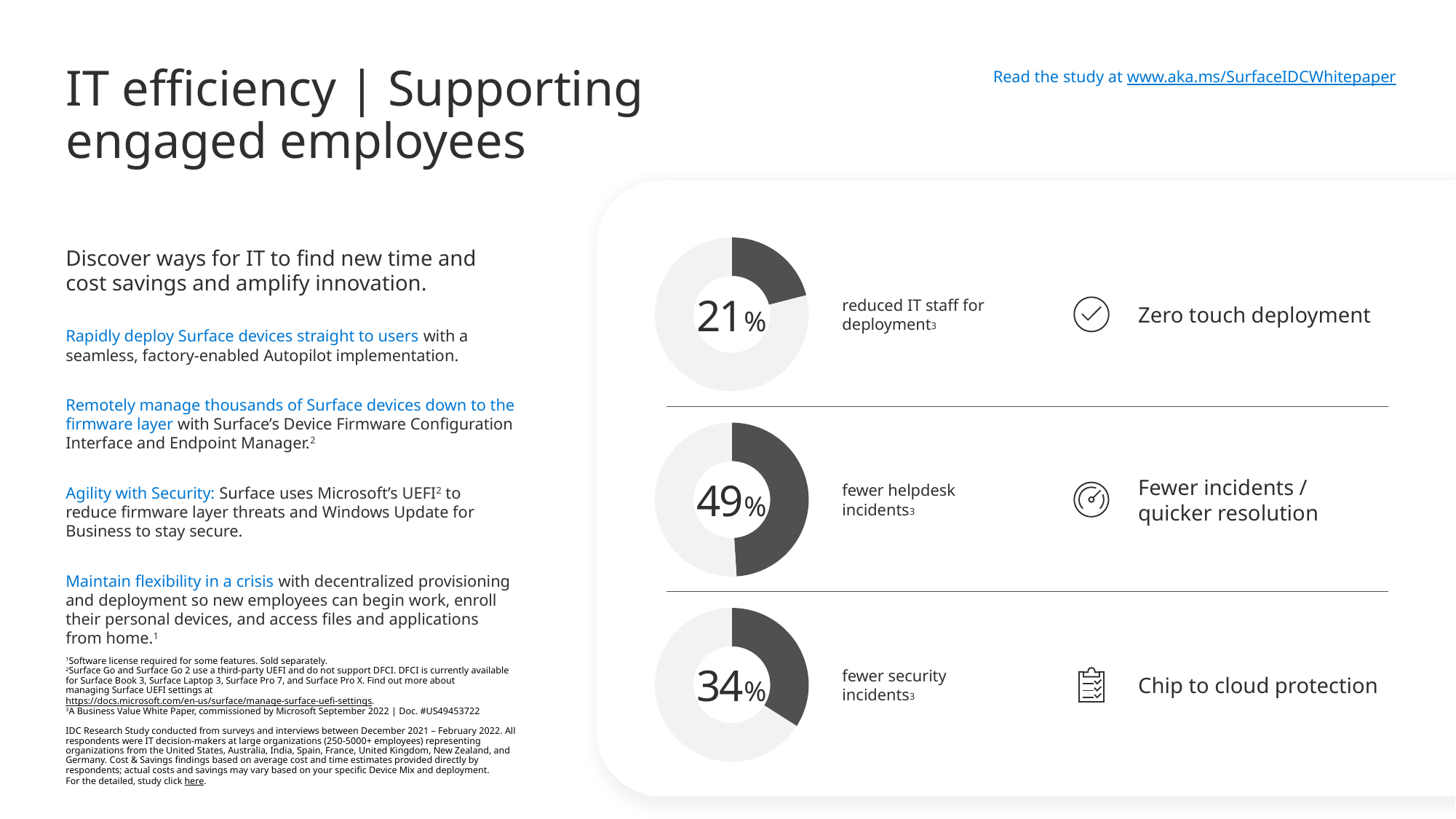
What colour is the filled segment in each donut chart? dark grey Which of the three donut charts shows the highest percentage? fewer helpdesk incidents (49%) What label appears to the right of the bottom donut chart? fewer security incidents How many donut charts are shown on the slide? 3 Which of the three donut charts shows the lowest percentage? reduced IT staff for deployment (21%) What value is shown in the top donut chart, for reduced IT staff for deployment? 21% What kind of chart is used to show the 21%, 49% and 34% values? donut chart Which is larger: the fewer security incidents value or the reduced IT staff for deployment value? fewer security incidents What is the difference between the fewer helpdesk incidents value and the fewer security incidents value? 15% What is the difference between the fewer helpdesk incidents value and the reduced IT staff for deployment value? 28% What value is shown in the bottom donut chart, for fewer security incidents? 34% What value is shown in the middle donut chart, for fewer helpdesk incidents? 49%